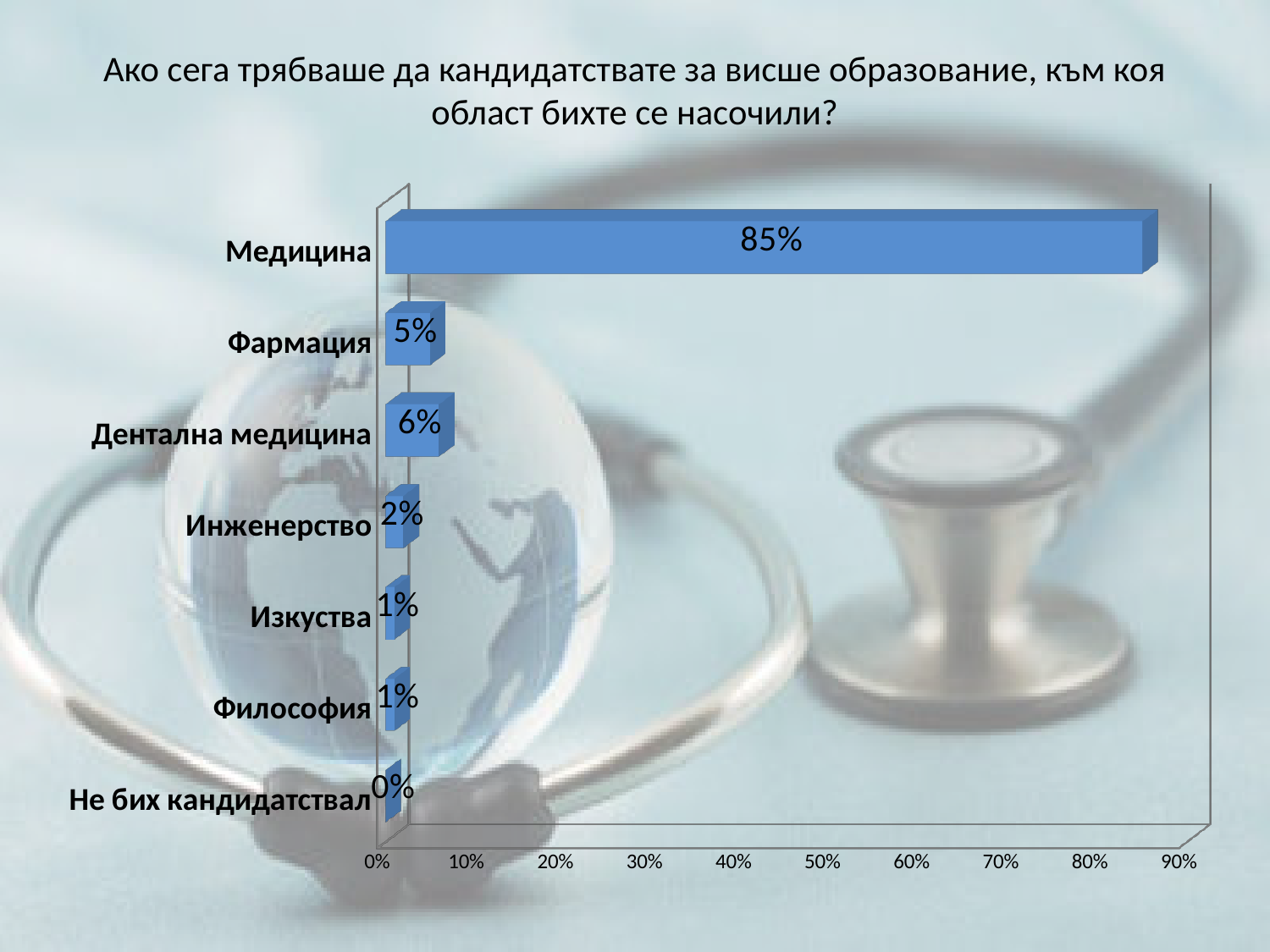
What is the value for Фармация? 5% Which is larger, the value for Дентална медицина or the value for Фармация? Дентална медицина What is the value for Дентална медицина? 6% What is the value for Медицина? 85% Which category has the lowest value? Не бих кандидатствал Is the value for Медицина greater or less than 80%? greater Which category has the highest value? Медицина What is the value for Не бих кандидатствал? 0% What is the value for Инженерство? 2% What is the difference between the values for Медицина and Дентална медицина? 79% What kind of chart is shown on the slide? bar chart How many categories are shown in the chart? 7